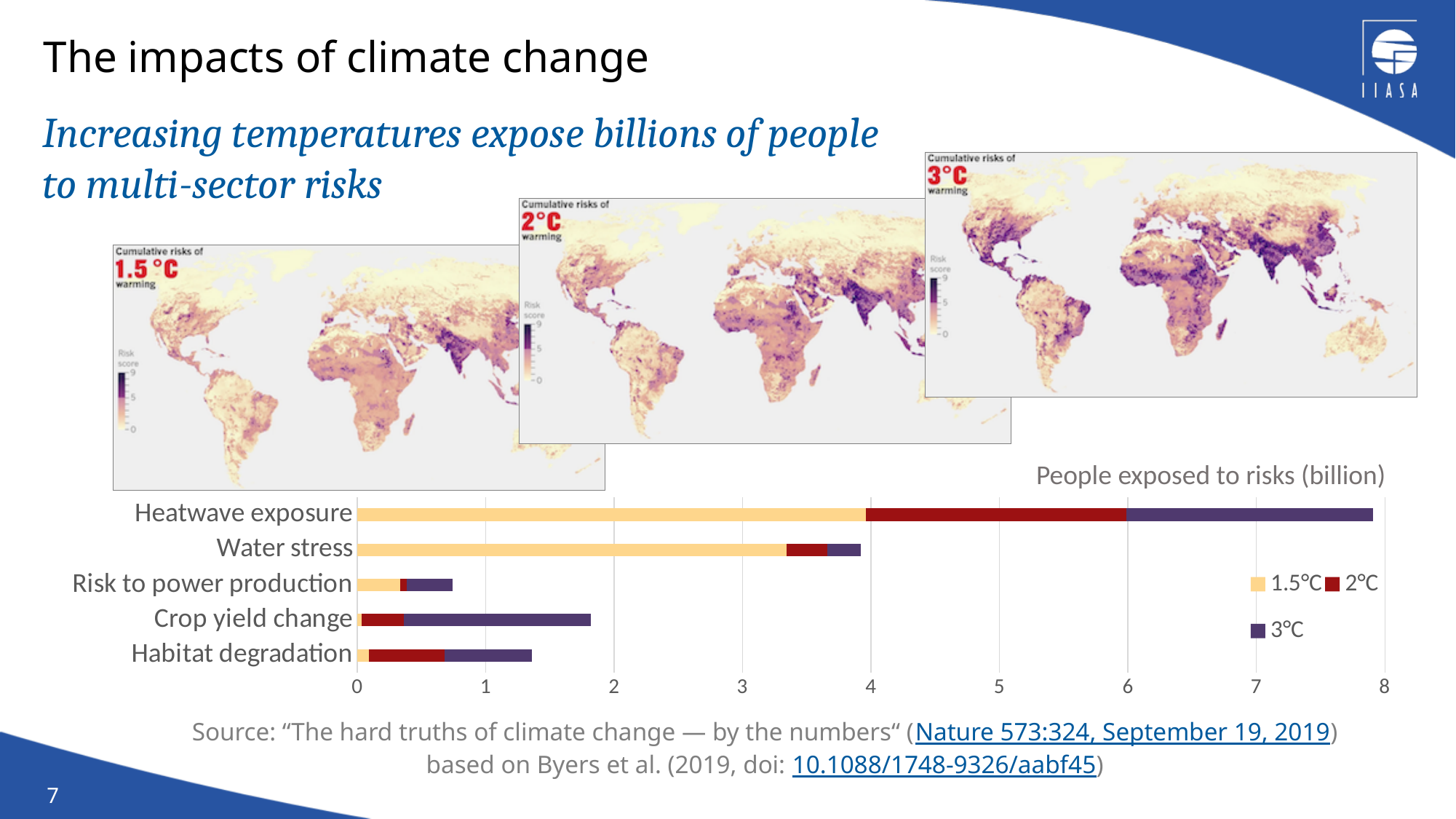
How many risk categories are shown in the "People exposed to risks (billion)" chart? 5 In the "People exposed to risks (billion)" chart, which has the longer total bar: Crop yield change or Habitat degradation? Crop yield change In the "People exposed to risks (billion)" chart, which category has the shortest total bar? Risk to power production In the "People exposed to risks (billion)" chart, is the total bar for Risk to power production greater or less than 1? less What kind of chart is the "People exposed to risks (billion)" chart? bar chart In the "People exposed to risks (billion)" chart, is the total bar for Heatwave exposure greater or less than 7? greater In the "People exposed to risks (billion)" chart, is the total bar for Crop yield change greater or less than 2? less What is the title of the bar chart on the slide? People exposed to risks (billion) In the "People exposed to risks (billion)" chart, which category has the longest total bar? Heatwave exposure How many series does the legend of the "People exposed to risks (billion)" chart list? 3 In the "People exposed to risks (billion)" chart, which series is shown in dark purple? 3℃